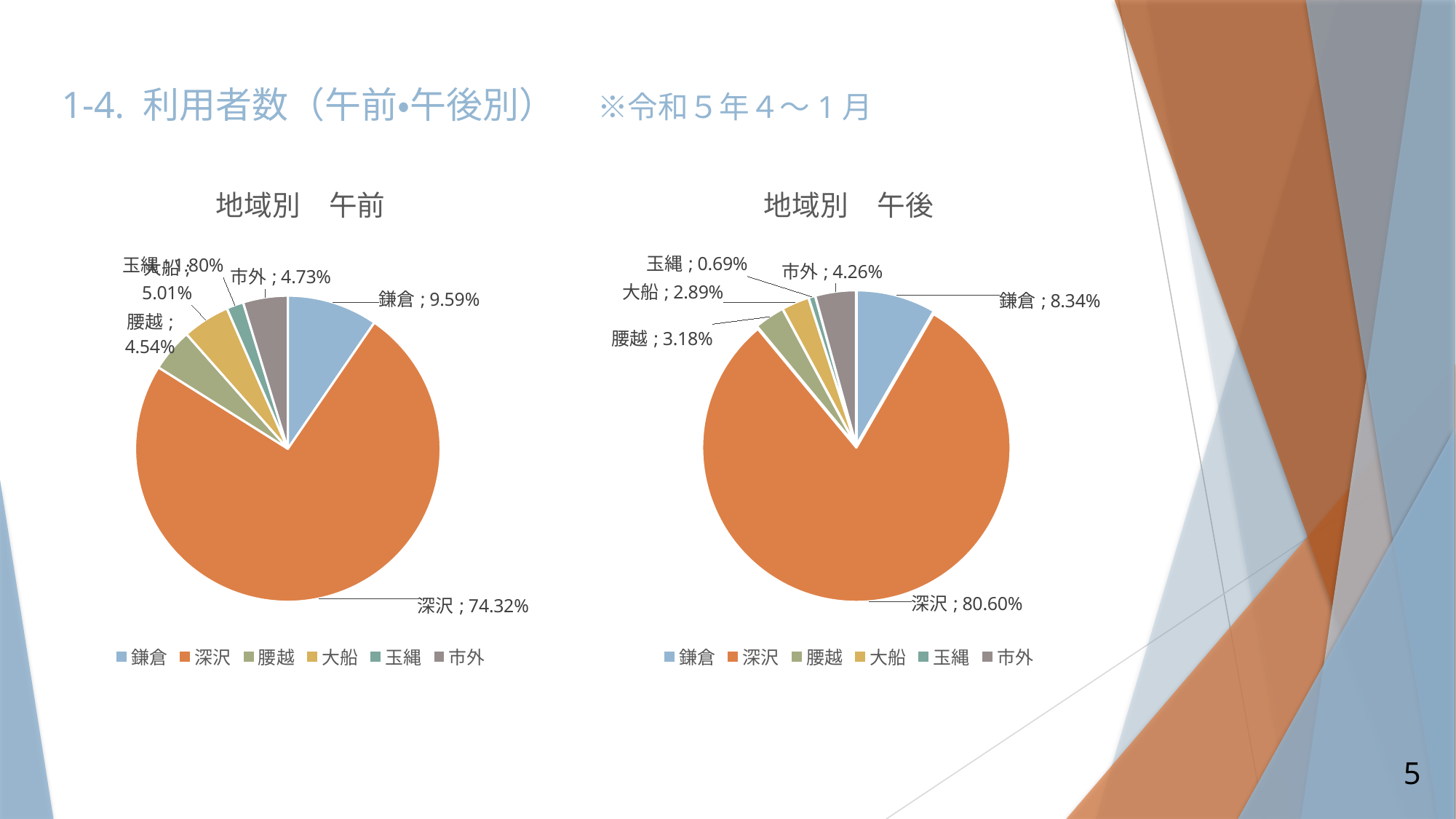
In the 地域別 午前 chart, which category has the largest slice? 深沢 In the 地域別 午後 chart, what is the value for 玉縄? 0.69% How many categories does the legend of the 地域別 午後 chart list? 6 In the 地域別 午後 chart, which is larger, 腰越 or 大船? 腰越 In the 地域別 午後 chart, what share does 深沢 have? 80.60% In the 地域別 午前 chart, what is the value for 鎌倉? 9.59% In the 地域別 午後 chart, which category has the smallest slice? 玉縄 In the 地域別 午前 chart, what share does 深沢 have? 74.32% In the 地域別 午後 chart, what is the value for 市外? 4.26% What is the title of the chart on the right side of the slide? 地域別 午後 In the 地域別 午前 chart, what is the difference between 大船 and 腰越? 0.47% What type of chart is the 地域別 午前 chart? Pie chart